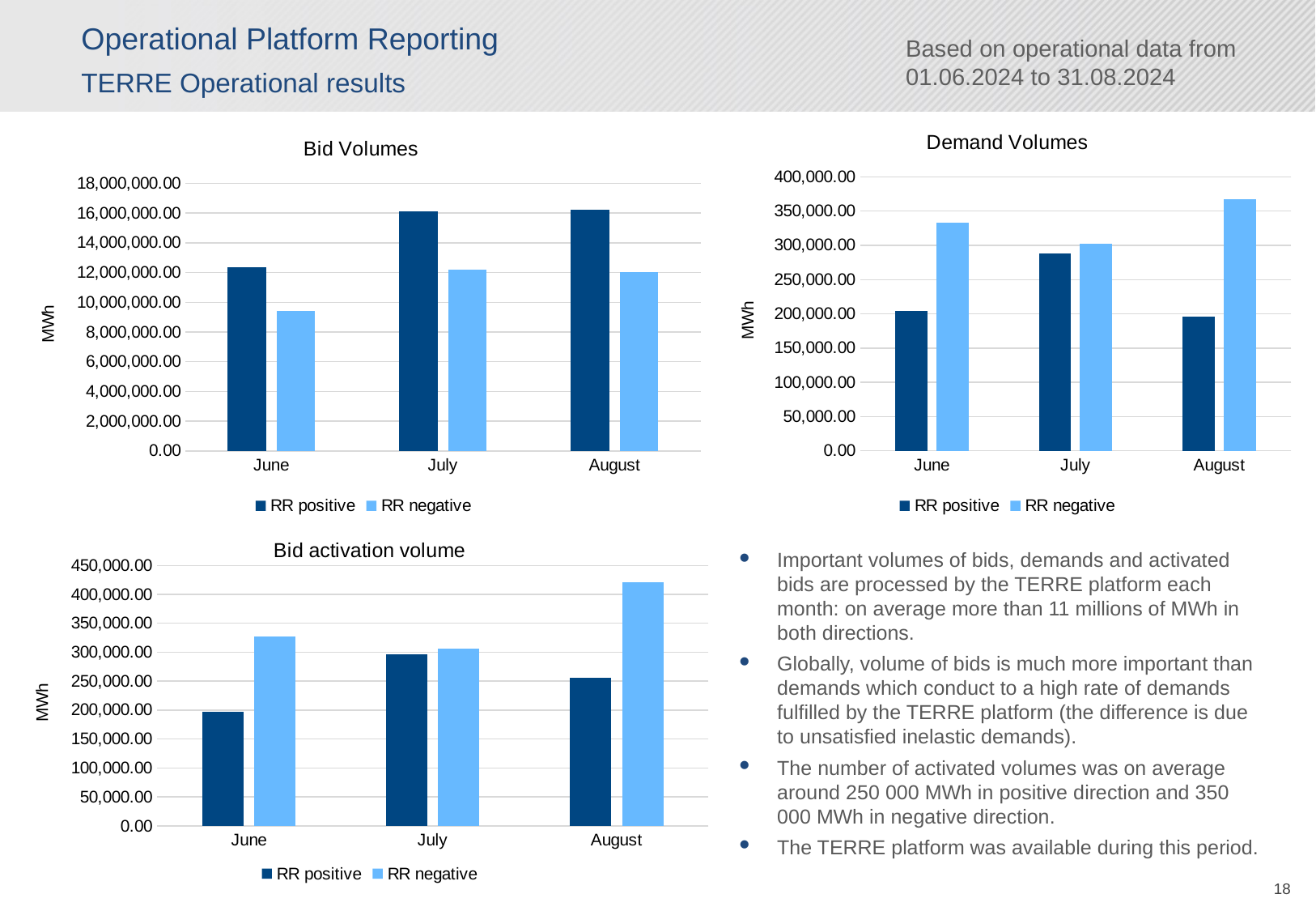
In the Bid Volumes chart, which month has the lowest RR negative bid volume? June In the Bid Volumes chart, which is larger for July: RR positive or RR negative? RR positive In the Demand Volumes chart, which month has the highest RR negative demand volume? August In the Bid activation volume chart, is the RR negative value for August greater or less than 400,000.00? greater In the Bid Volumes chart, is the RR negative value for June greater or less than 10,000,000.00? less In the Bid activation volume chart, which month has the highest RR negative value? August How many series does the legend of the Demand Volumes chart list? 2 What type of chart is the Bid activation volume chart? Bar chart In the Demand Volumes chart, which month has the highest RR positive demand volume? July In the Bid Volumes chart, is the RR positive value for June greater or less than 12,000,000.00? greater In the Bid activation volume chart, which is larger for June: RR positive or RR negative? RR negative